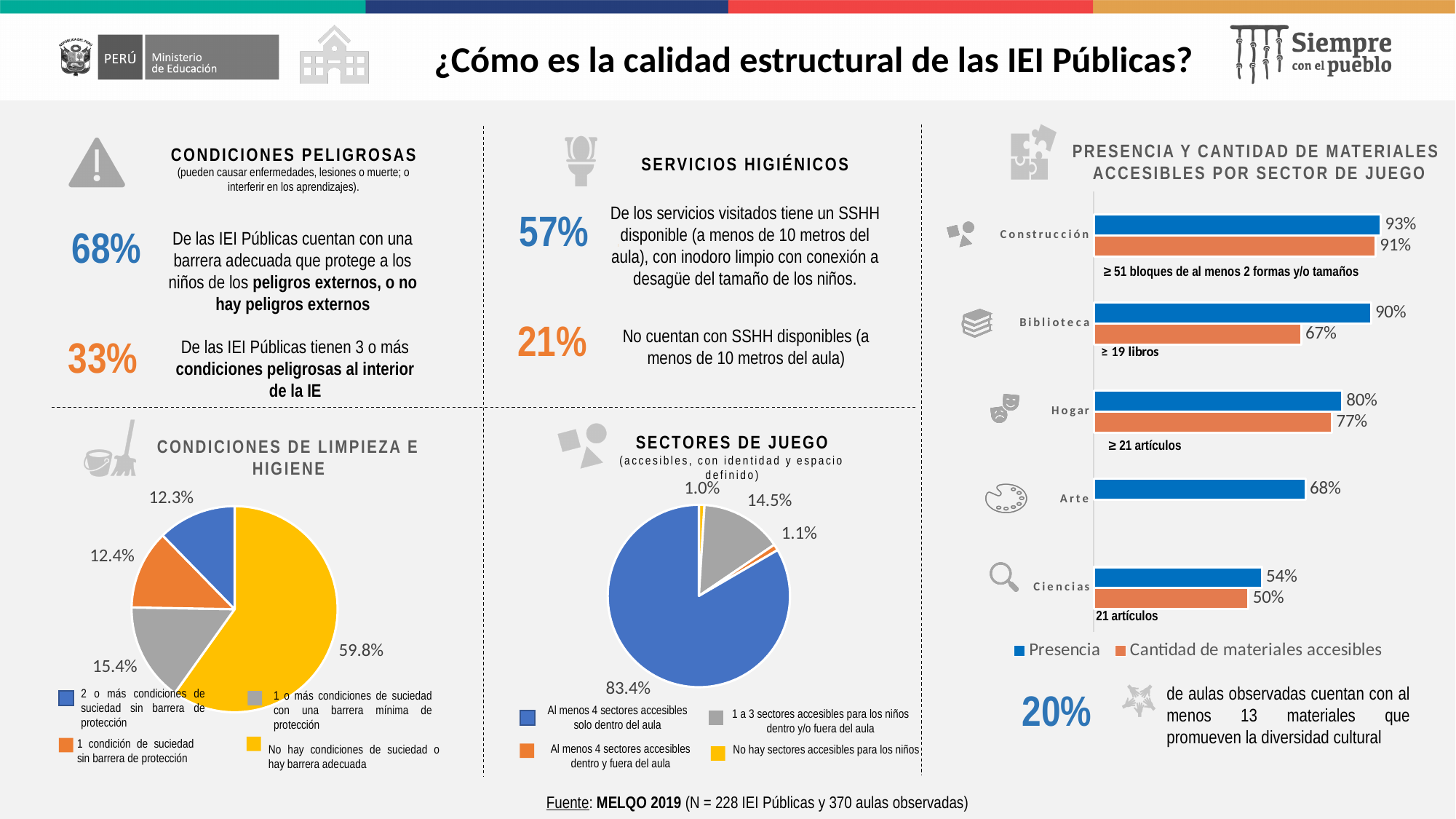
In the pie chart 'Sectores de juego', what share is '1 a 3 sectores accesibles para los niños dentro y/o fuera del aula'? 14.5% In the bar chart 'Presencia y cantidad de materiales accesibles por sector de juego', how many sectors (categories) are shown? 5 In the bar chart 'Presencia y cantidad de materiales accesibles por sector de juego', what is the difference between the Presencia and 'Cantidad de materiales accesibles' values for Biblioteca? 23% In the bar chart 'Presencia y cantidad de materiales accesibles por sector de juego', what is the Presencia value for Biblioteca? 90% In the pie chart 'Sectores de juego', which is larger: 'Al menos 4 sectores accesibles solo dentro del aula' or '1 a 3 sectores accesibles para los niños dentro y/o fuera del aula'? Al menos 4 sectores accesibles solo dentro del aula In the pie chart 'Condiciones de limpieza e higiene', which category has the smallest slice? 2 o más condiciones de suciedad sin barrera de protección In the pie chart 'Condiciones de limpieza e higiene', what share is 'No hay condiciones de suciedad o hay barrera adecuada'? 59.8% In the bar chart 'Presencia y cantidad de materiales accesibles por sector de juego', how many series does the legend list? 2 In the bar chart 'Presencia y cantidad de materiales accesibles por sector de juego', which sector has the highest Presencia value? Construcción What kind of chart is 'Presencia y cantidad de materiales accesibles por sector de juego'? Bar chart In the bar chart 'Presencia y cantidad de materiales accesibles por sector de juego', which sector has the lowest Presencia value? Ciencias In the bar chart 'Presencia y cantidad de materiales accesibles por sector de juego', what is the 'Cantidad de materiales accesibles' value for Ciencias? 50%